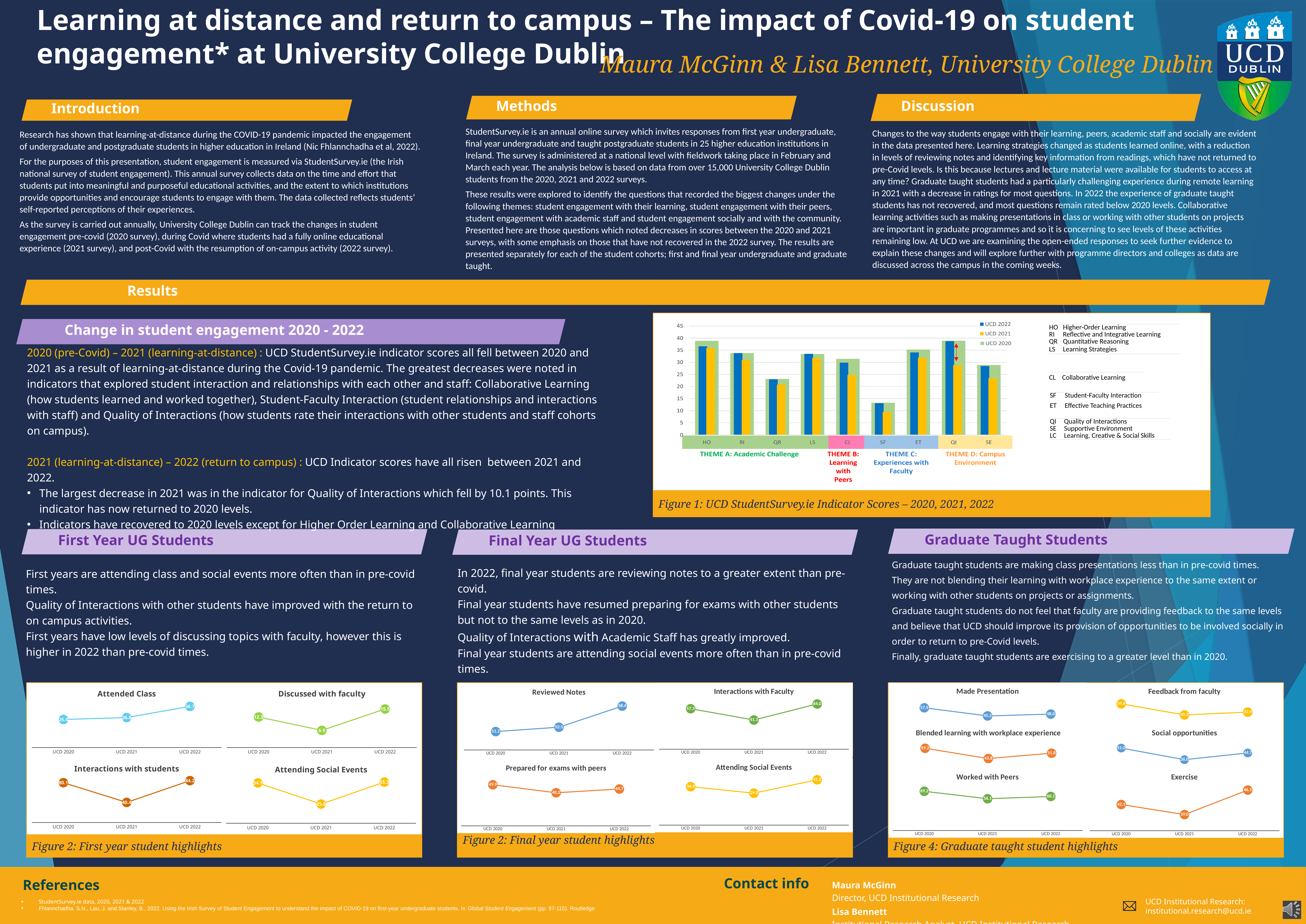
In the First year student highlights chart 'Interactions with students', what is the value for UCD 2022? 84.2 In Figure 1 (UCD StudentSurvey.ie Indicator Scores), which indicator has the lowest scores across all three years? SF What kind of chart is Figure 1 (UCD StudentSurvey.ie Indicator Scores – 2020, 2021, 2022)? bar chart In the Graduate taught student highlights chart 'Worked with Peers', what is the value for UCD 2020? 69.2 In Figure 1 (UCD StudentSurvey.ie Indicator Scores), how many indicator categories are shown on the x axis? 9 In the Graduate taught student highlights chart 'Exercise', which is larger: the UCD 2020 value or the UCD 2022 value? UCD 2022 In Figure 1 (UCD StudentSurvey.ie Indicator Scores), how many series does the legend list? 3 In Figure 1 (UCD StudentSurvey.ie Indicator Scores), which colour represents UCD 2022 in the legend? blue In the Final year student highlights chart 'Reviewed Notes', what is the value for UCD 2022? 58.4 In the First year student highlights chart 'Discussed with faculty', what is the value for UCD 2021? 6.9 In the First year student highlights chart 'Interactions with students', what is the difference between the UCD 2020 and UCD 2021 values? 39.7 In Figure 1 (UCD StudentSurvey.ie Indicator Scores), is the UCD 2022 value for QI greater or less than 35? greater